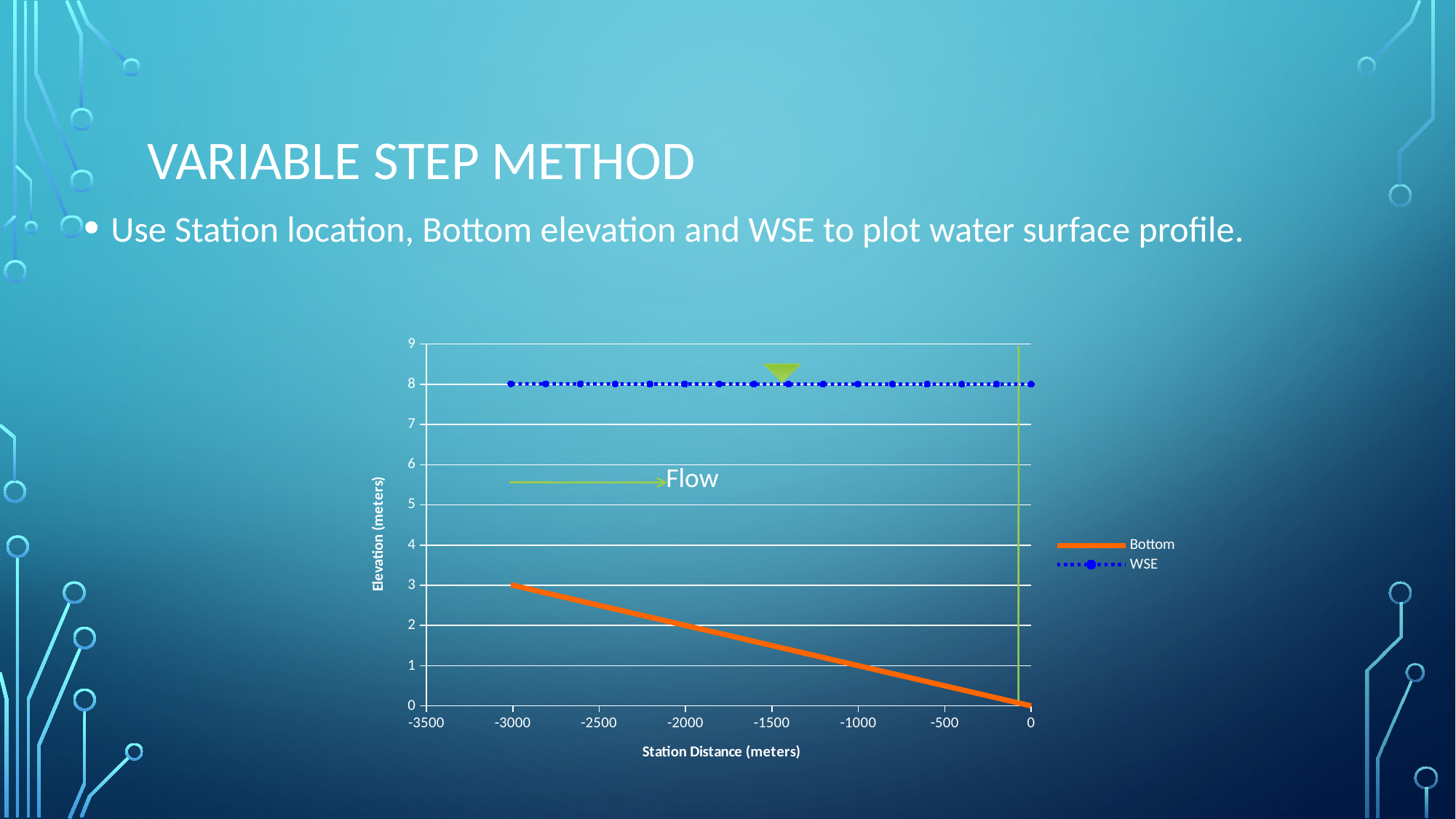
What is the difference between the WSE and Bottom values at station distance -3000? 5 Is the Bottom elevation at station distance -1500 greater or less than 2? less How many series does the legend list? 2 What is the Bottom elevation at station distance 0? 0 What is the WSE value at station distance -3000? 8 What kind of chart is shown on the slide? line chart What is the title of the horizontal axis? Station Distance (meters) Does the Bottom series rise or fall as station distance goes from -3000 to 0? fall Does the WSE series rise, fall, or stay flat across the station distances? stay flat How many data points are plotted for the WSE series? 16 What is the Bottom elevation at station distance -3000? 3 At station distance -2000, which series has the higher value, Bottom or WSE? WSE